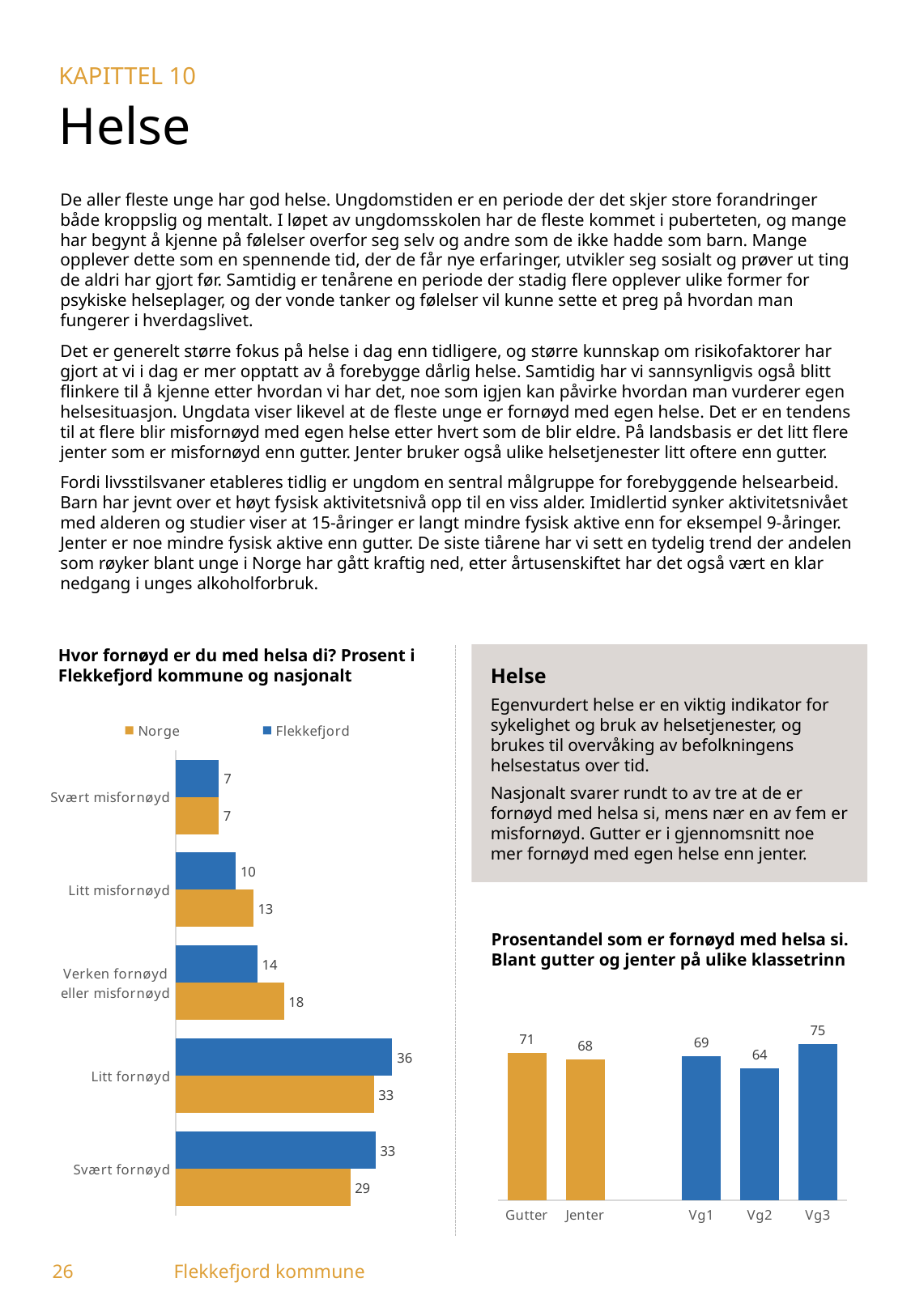
In the chart 'Prosentandel som er fornøyd med helsa si', what is the difference between Gutter and Jenter? 3 How many series does the legend list in the chart 'Hvor fornøyd er du med helsa di?'? 2 In the chart 'Prosentandel som er fornøyd med helsa si', which category has the highest value? Vg3 In the chart 'Prosentandel som er fornøyd med helsa si', what is the value for Vg2? 64 In the chart 'Hvor fornøyd er du med helsa di?', what is the difference between the Norge and Flekkefjord values for Svært fornøyd? 4 In the chart 'Hvor fornøyd er du med helsa di?', which category has the highest Flekkefjord value? Litt fornøyd In the chart 'Hvor fornøyd er du med helsa di?', what is the Flekkefjord value for Litt fornøyd? 36 In the chart 'Hvor fornøyd er du med helsa di?', which category has the lowest Norge value? Svært misfornøyd In the chart 'Hvor fornøyd er du med helsa di?', which is larger for Litt misfornøyd: Norge or Flekkefjord? Norge What kind of chart is 'Prosentandel som er fornøyd med helsa si'? Bar chart In the chart 'Hvor fornøyd er du med helsa di?', what is the Norge value for Verken fornøyd eller misfornøyd? 18 How many categories are shown in the chart 'Hvor fornøyd er du med helsa di?'? 5